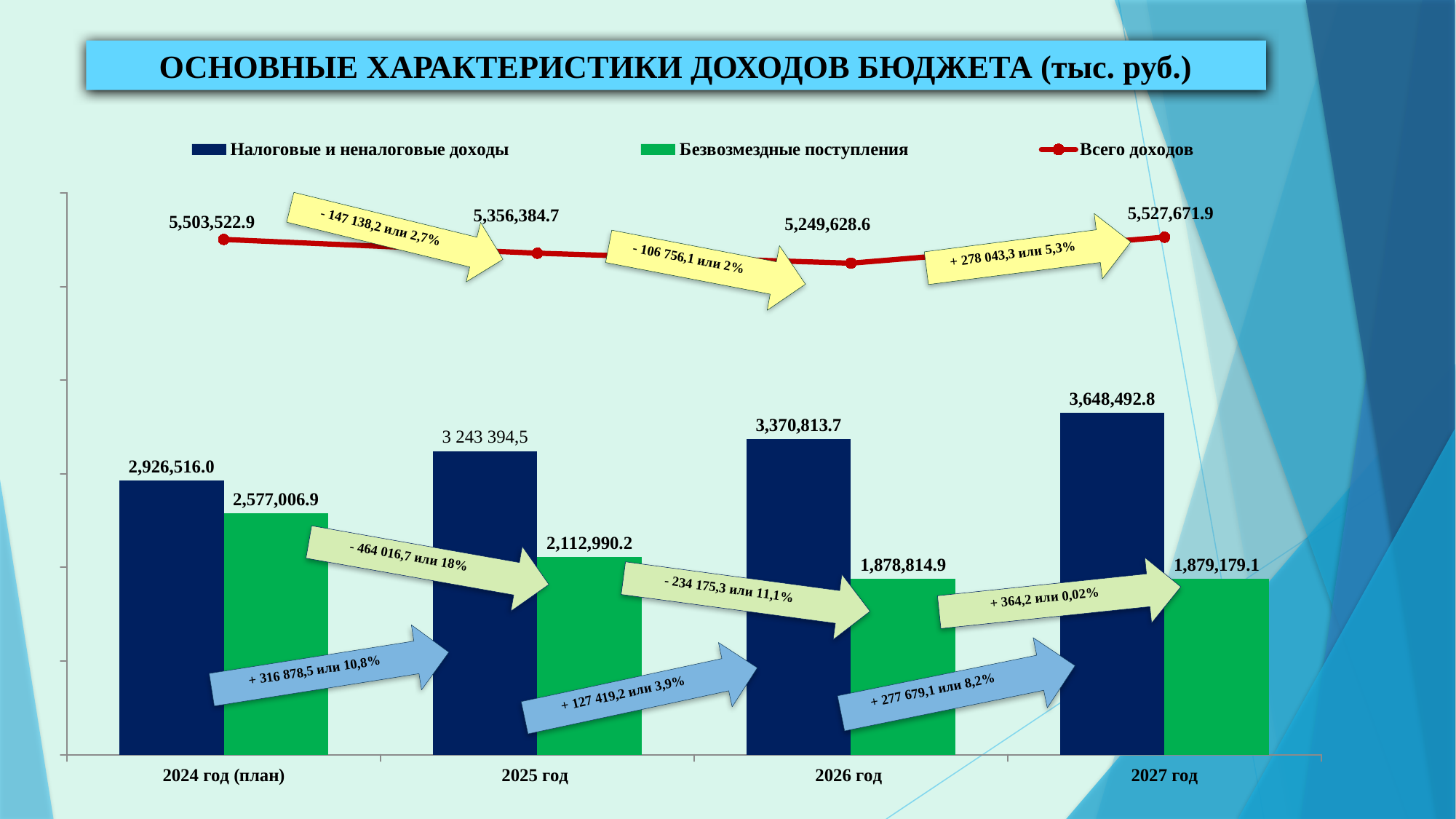
Which is larger in 2024 год (план): Налоговые и неналоговые доходы or Безвозмездные поступления? Налоговые и неналоговые доходы In which year is Всего доходов the highest? 2027 год How many years are shown on the x axis? 4 What is the value of Налоговые и неналоговые доходы for 2027 год? 3,648,492.8 What is the difference between Налоговые и неналоговые доходы in 2027 год and in 2026 год? 277,679.1 What is the value of Безвозмездные поступления for 2025 год? 2,112,990.2 How many series does the legend list? 3 What is the value of Налоговые и неналоговые доходы for 2024 год (план)? 2,926,516.0 What is the value of Всего доходов for 2026 год? 5,249,628.6 In which year is Всего доходов the lowest? 2026 год In which year is Безвозмездные поступления the highest? 2024 год (план) Do the values of Налоговые и неналоговые доходы rise or fall from 2024 год (план) to 2027 год? rise